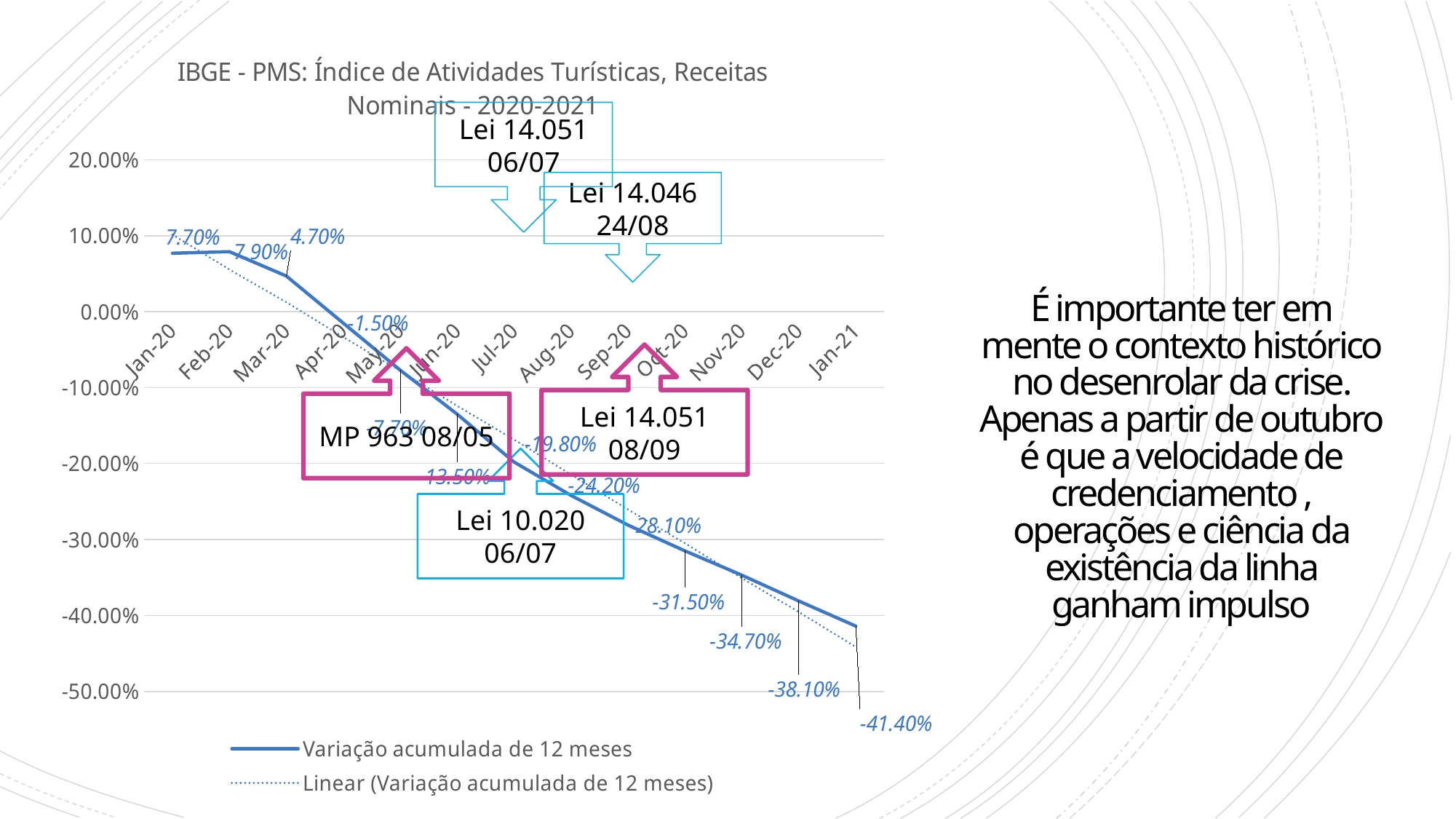
What is the value of 'Variação acumulada de 12 meses' for Jan-20? 7.70% What is the value of 'Variação acumulada de 12 meses' for Nov-20? -34.70% What type of chart is shown on the slide? Line chart What is the value of 'Variação acumulada de 12 meses' for Jan-21? -41.40% Which month has the lowest value of 'Variação acumulada de 12 meses'? Jan-21 How many months are plotted on the x axis? 13 How many entries does the legend list? 2 Does the 'Variação acumulada de 12 meses' line generally rise or fall from Feb-20 to Jan-21? Fall Which is larger, the value for Aug-20 or the value for Oct-20? Aug-20 Which month has the highest value of 'Variação acumulada de 12 meses'? Feb-20 What is the difference between the values for Dec-20 (-38.10%) and Jan-21 (-41.40%)? 3.30 percentage points What is the value of 'Variação acumulada de 12 meses' for Mar-20? 4.70%